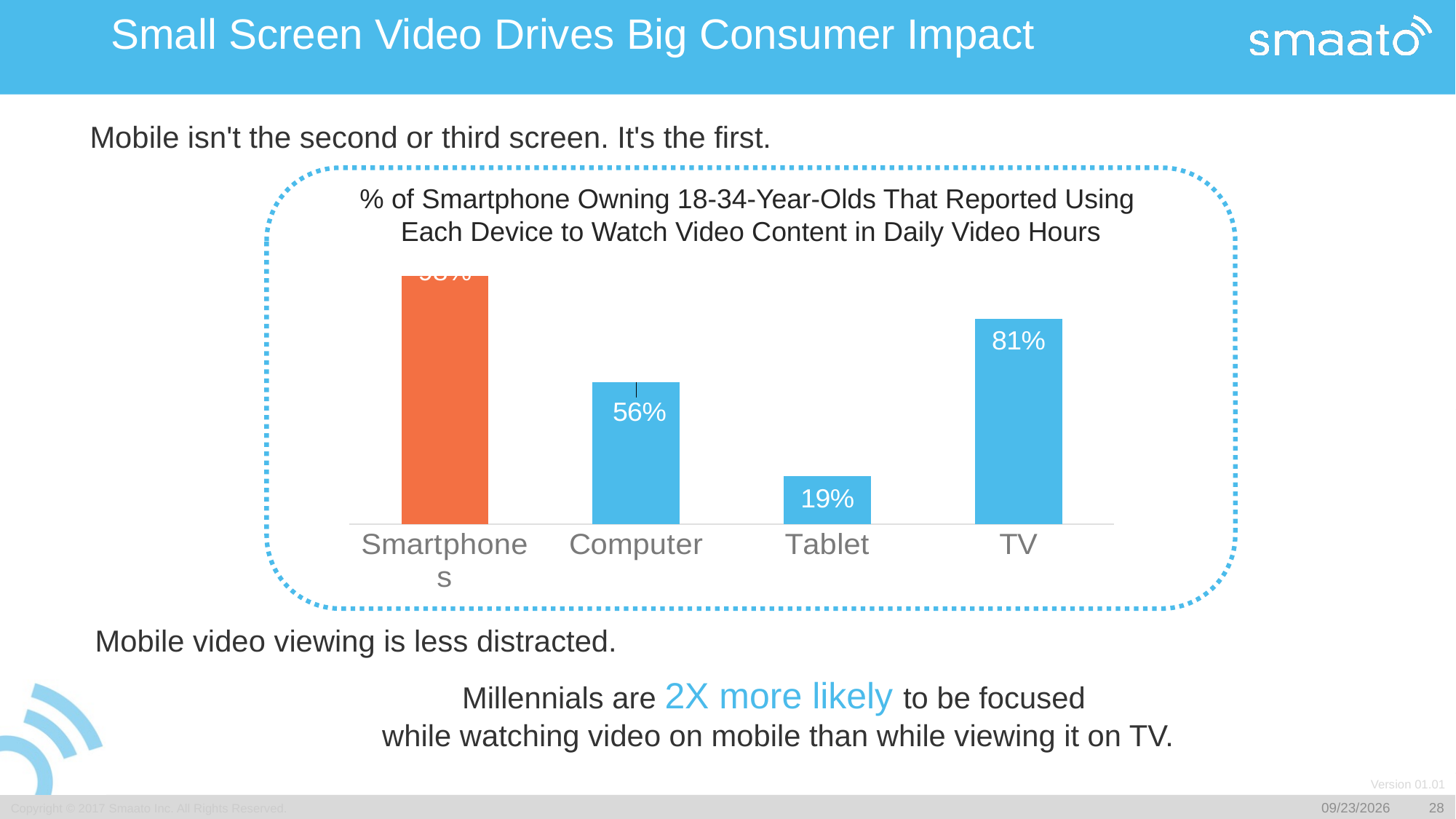
How many devices are shown in the chart? 4 What is the difference between the TV and Tablet percentages? 62% What percentage is shown for Tablet? 19% What type of chart is shown on the slide? Bar chart What percentage is shown for TV? 81% Which device's bar is coloured orange rather than blue? Smartphones What is the difference between the TV and Computer percentages? 25% Which device has the lowest percentage? Tablet What percentage is shown for Computer? 56% Which has a higher percentage, TV or Computer? TV What is the difference between the Computer and Tablet percentages? 37% Which device has the tallest bar in the chart? Smartphones